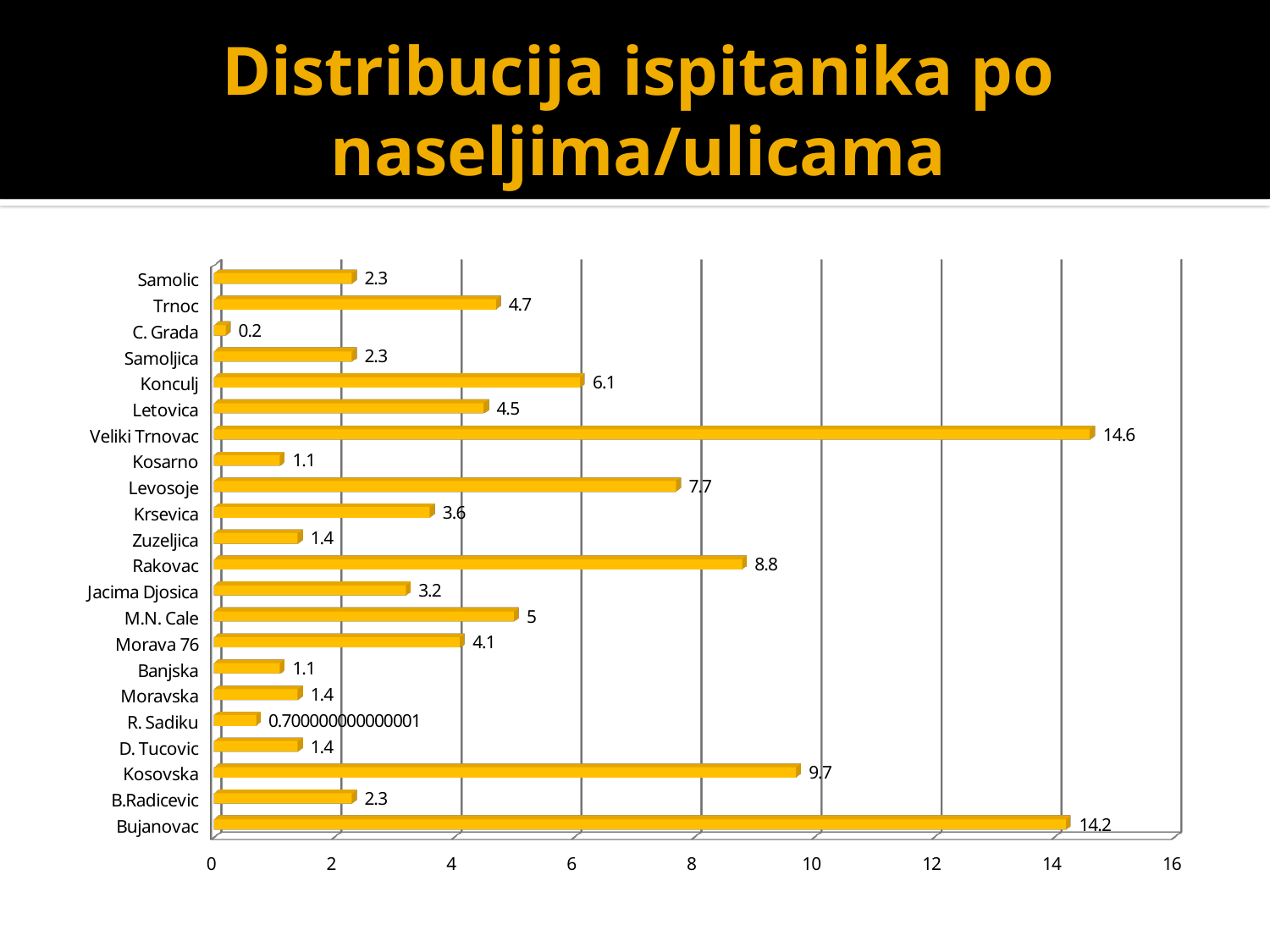
What is the value for Levosoje? 7.7 Is the value for Kosovska greater or less than 8? greater Which is larger, the value for Konculj or the value for Trnoc? Konculj Which category has the lowest value? C. Grada What kind of chart is shown on the slide? bar chart What is the difference between the values for Bujanovac and Rakovac? 5.4 What is the value for Morava 76? 4.1 What is the title of the slide? Distribucija ispitanika po naseljima/ulicama What is the value for Kosovska? 9.7 How many categories are shown on the chart? 22 Which category has the highest value? Veliki Trnovac What is the value for Veliki Trnovac? 14.6